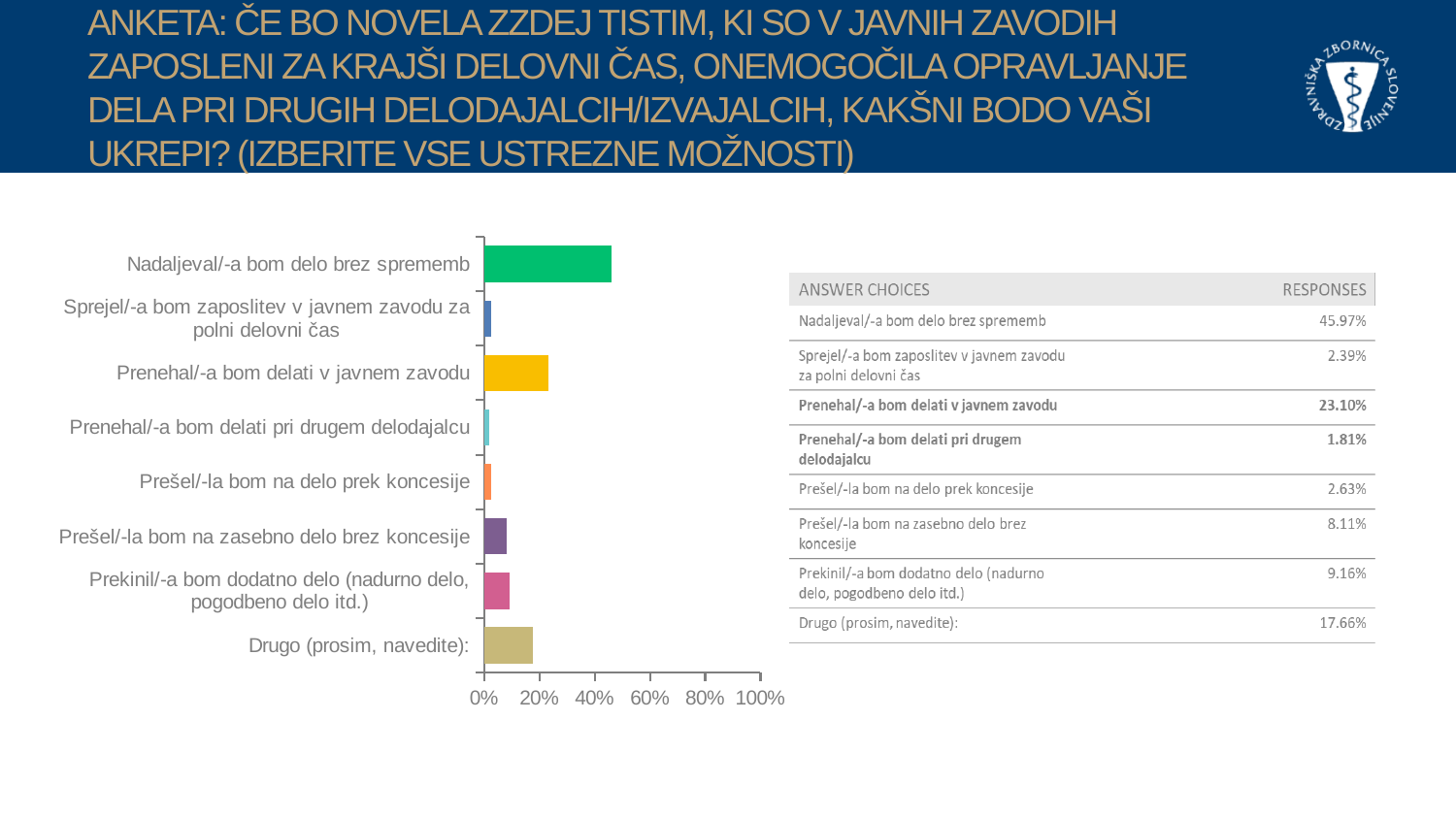
How many categories does the bar chart show? 8 Using the values in the table, what is the difference between 'Nadaljeval/-a bom delo brez sprememb' and 'Prenehal/-a bom delati v javnem zavodu'? 22.87% According to the table on the slide, what is the response share for 'Prešel/-la bom na zasebno delo brez koncesije'? 8.11% According to the table on the slide, what is the response share for 'Drugo (prosim, navedite):'? 17.66% Is the value for 'Nadaljeval/-a bom delo brez sprememb' greater or less than 40%? greater Which is larger: the value for 'Prekinil/-a bom dodatno delo (nadurno delo, pogodbeno delo itd.)' or the value for 'Prešel/-la bom na delo prek koncesije'? Prekinil/-a bom dodatno delo (nadurno delo, pogodbeno delo itd.) According to the table on the slide, what is the response share for 'Nadaljeval/-a bom delo brez sprememb'? 45.97% According to the table on the slide, what is the response share for 'Prenehal/-a bom delati v javnem zavodu'? 23.10% Which category has the lowest value in the chart? Prenehal/-a bom delati pri drugem delodajalcu Which category has the highest value in the chart? Nadaljeval/-a bom delo brez sprememb What kind of chart is shown on the slide? bar chart Is the value for 'Prenehal/-a bom delati v javnem zavodu' greater or less than 40%? less